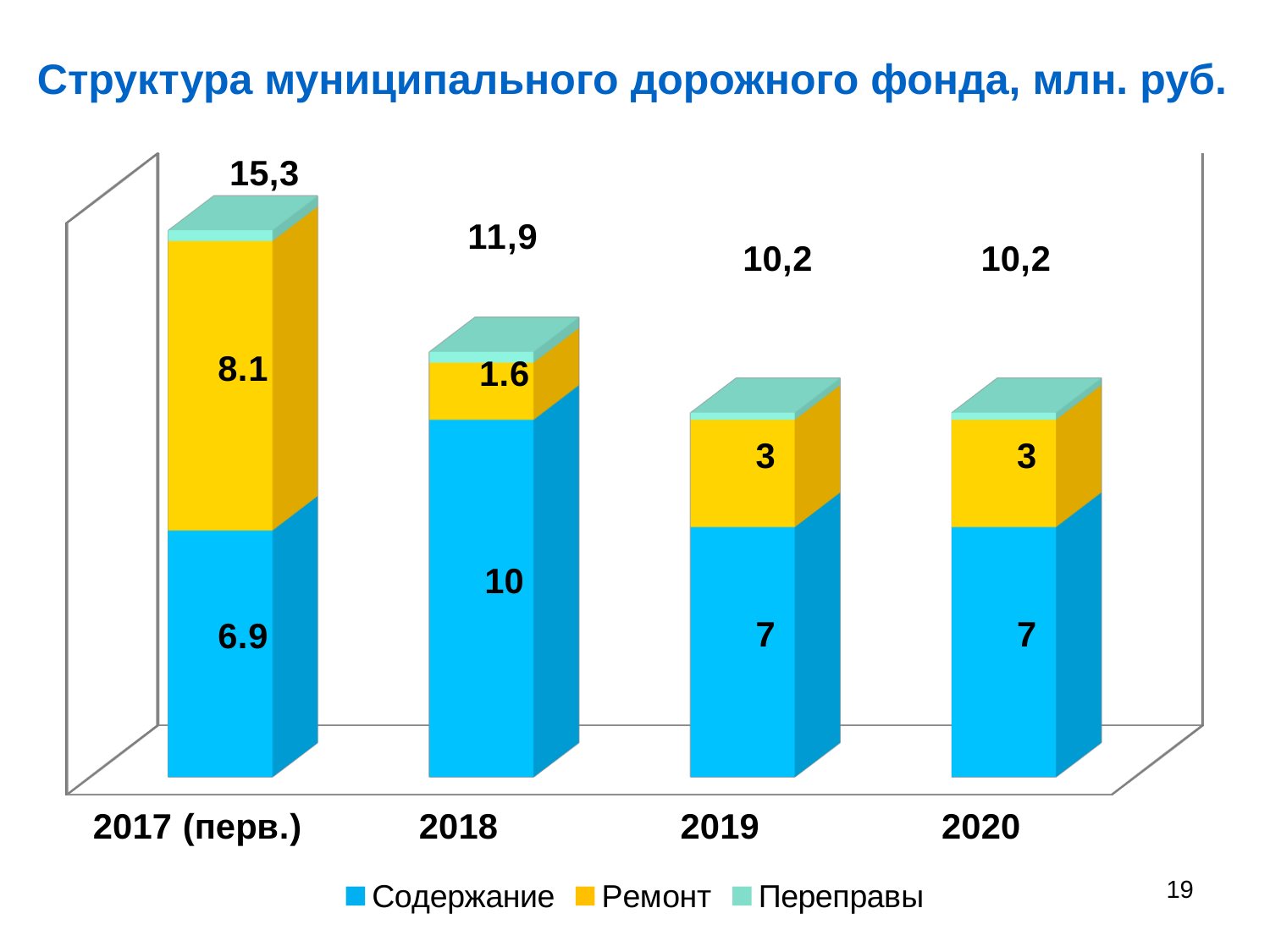
What is the value of Ремонт for 2017 (перв.)? 8.1 By how much is Содержание in 2018 greater than in 2017 (перв.)? 3.1 Which is larger: Ремонт in 2017 (перв.) or Ремонт in 2019? 2017 (перв.) What is the total shown above the bar for 2019? 10,2 How many series does the legend list? 3 What is the value of Содержание for 2018? 10 Which year has the lowest value for Ремонт? 2018 What is the difference between the totals for 2017 (перв.) and 2018? 3,4 What kind of chart is shown on the slide? Stacked bar chart How many years are shown on the x axis? 4 Do the total values rise or fall from 2017 (перв.) to 2020? Fall Which year has the highest total value? 2017 (перв.)